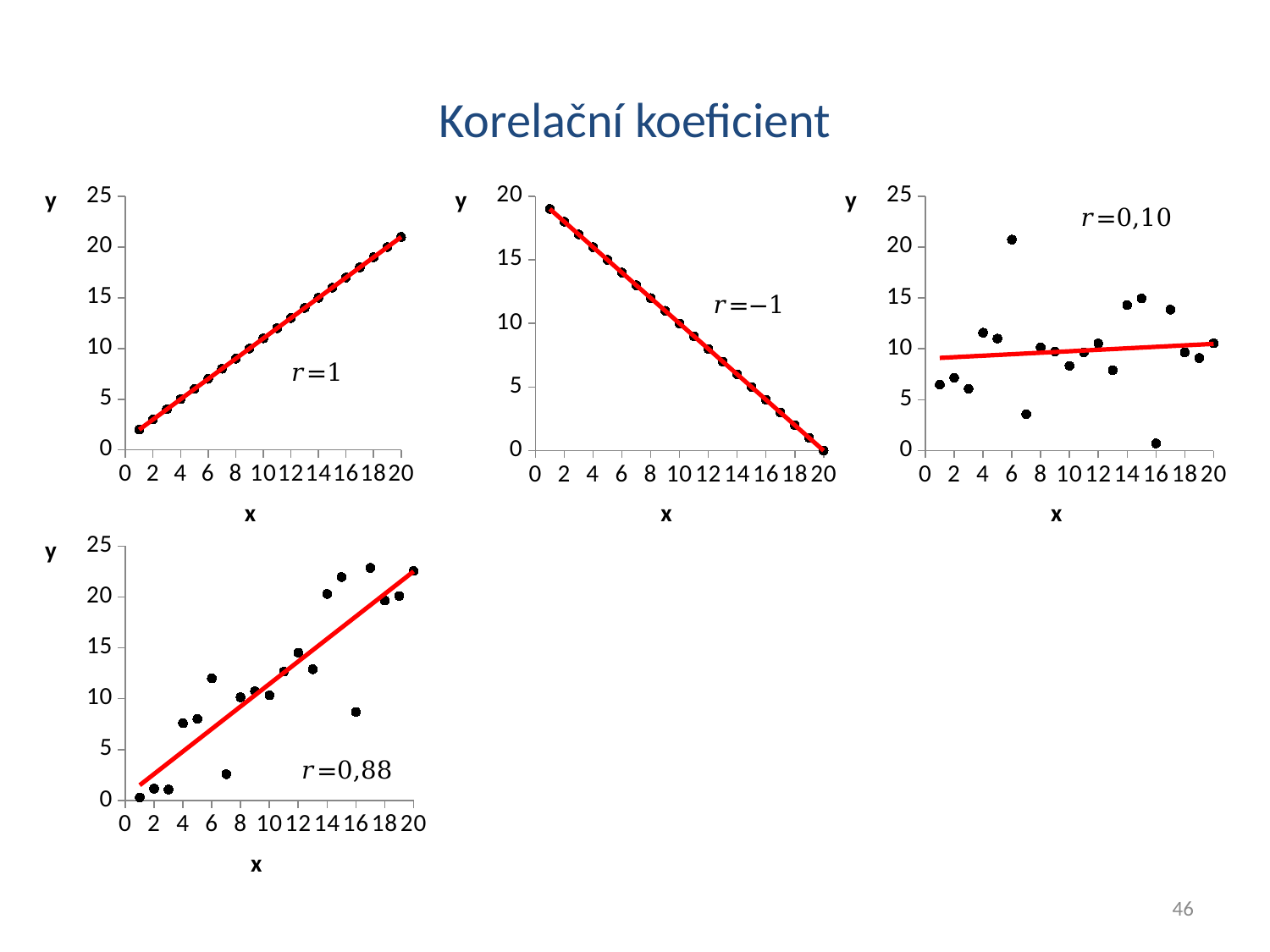
In the top-left chart (r=1), do the y values rise or fall as x increases? rise What correlation coefficient is printed on the top-right chart? r=0,10 In the top-middle chart (r=-1), do the y values rise or fall as x increases? fall In the bottom-left chart (r=0,88), is the y value at x=16 greater or less than 10? less How many data points are plotted in the top-left chart (r=1)? 20 In the bottom-left chart (r=0,88), which has the larger y value, the point at x=6 or the point at x=7? x=6 In the top-right chart (r=0,10), at which x value is the highest point? 6 In the top-right chart (r=0,10), at which x value is the lowest point? 16 In the top-middle chart (r=-1), is the y value at x=1 greater or less than 15? greater What kind of chart is the top-left chart labelled r=1? scatter chart In the bottom-left chart (r=0,88), do the y values generally rise or fall as x increases? rise In the bottom-left chart (r=0,88), is the y value at x=17 greater or less than 20? greater